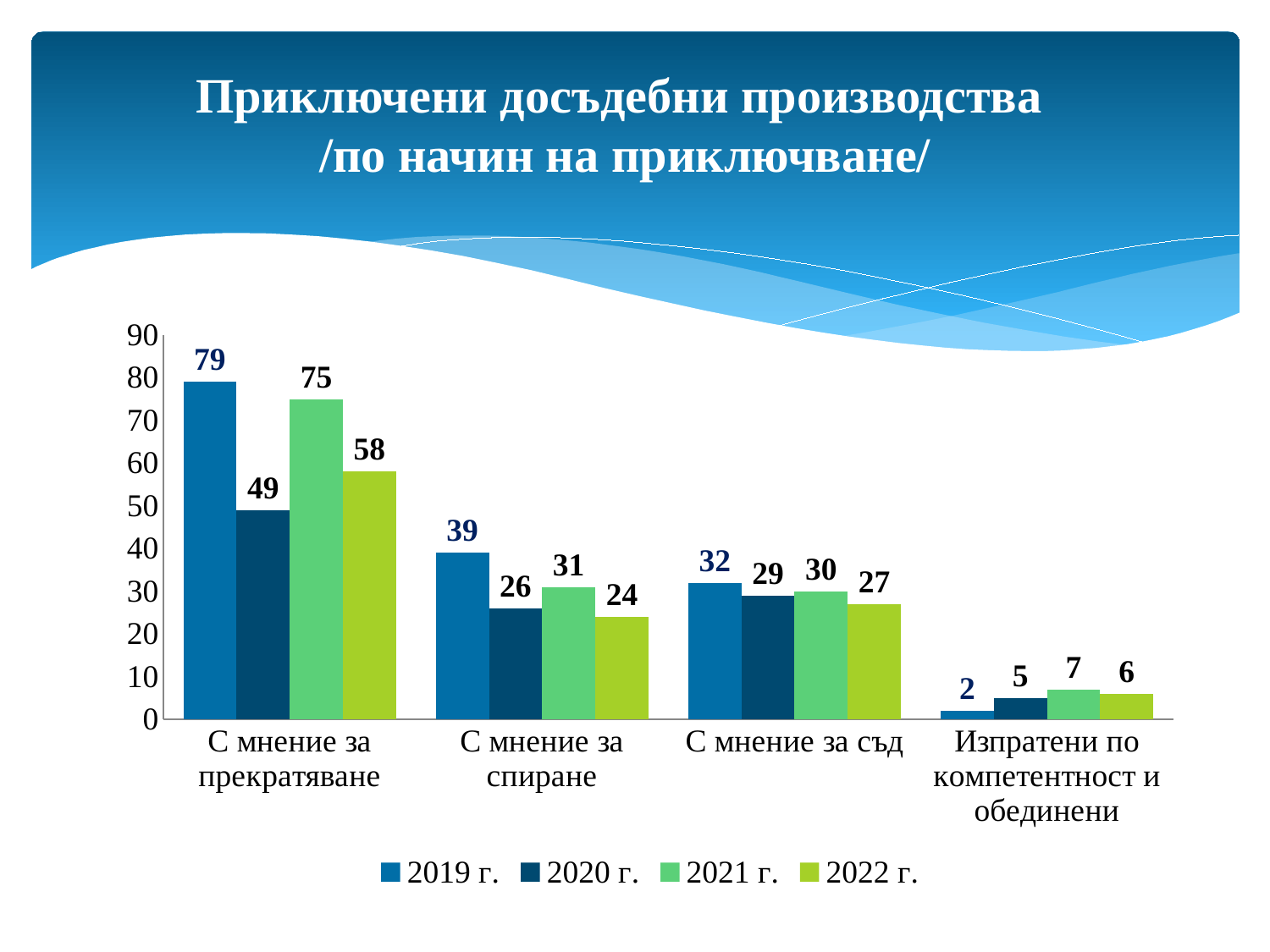
What is the value for 2022 г. in the category "С мнение за спиране"? 24 Which category has the lowest value for 2021 г.? Изпратени по компетентност и обединени What is the difference between the 2021 г. and 2022 г. values in the category "С мнение за спиране"? 7 How many series does the legend list? 4 What is the title of the chart on the slide? Приключени досъдебни производства /по начин на приключване/ What is the value for 2019 г. in the category "С мнение за прекратяване"? 79 What kind of chart is shown on the slide? Bar chart How many categories are shown on the x axis? 4 Which category has the highest value for 2020 г.? С мнение за прекратяване Which is larger in the category "С мнение за съд": the value for 2019 г. or the value for 2022 г.? 2019 г. What is the difference between the 2019 г. and 2020 г. values in the category "С мнение за прекратяване"? 30 What is the value for 2021 г. in the category "Изпратени по компетентност и обединени"? 7